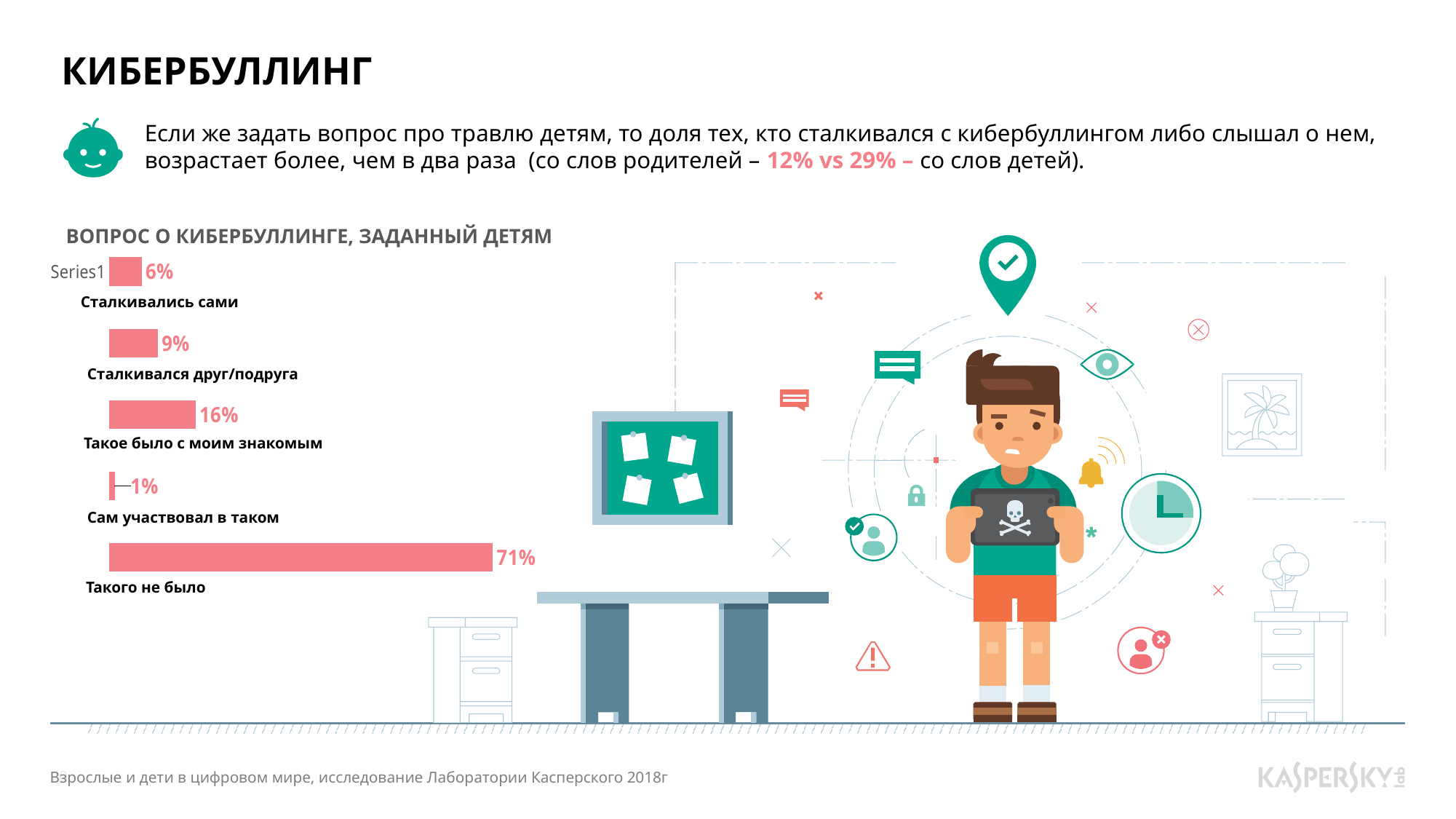
What value is shown for "Сталкивались сами"? 6% What is the title of the chart? ВОПРОС О КИБЕРБУЛЛИНГЕ, ЗАДАННЫЙ ДЕТЯМ Which category has the highest value? Такого не было Which is larger: the value for "Сталкивался друг/подруга" or the value for "Сталкивались сами"? Сталкивался друг/подруга What value is shown for "Сам участвовал в таком"? 1% What value is shown for "Такое было с моим знакомым"? 16% What is the difference between the values for "Такое было с моим знакомым" and "Сталкивались сами"? 10% What kind of chart is shown on the slide? Bar chart How many categories does the chart show? 5 What value is shown for "Такого не было"? 71% What value is shown for "Сталкивался друг/подруга"? 9% Which category has the lowest value? Сам участвовал в таком